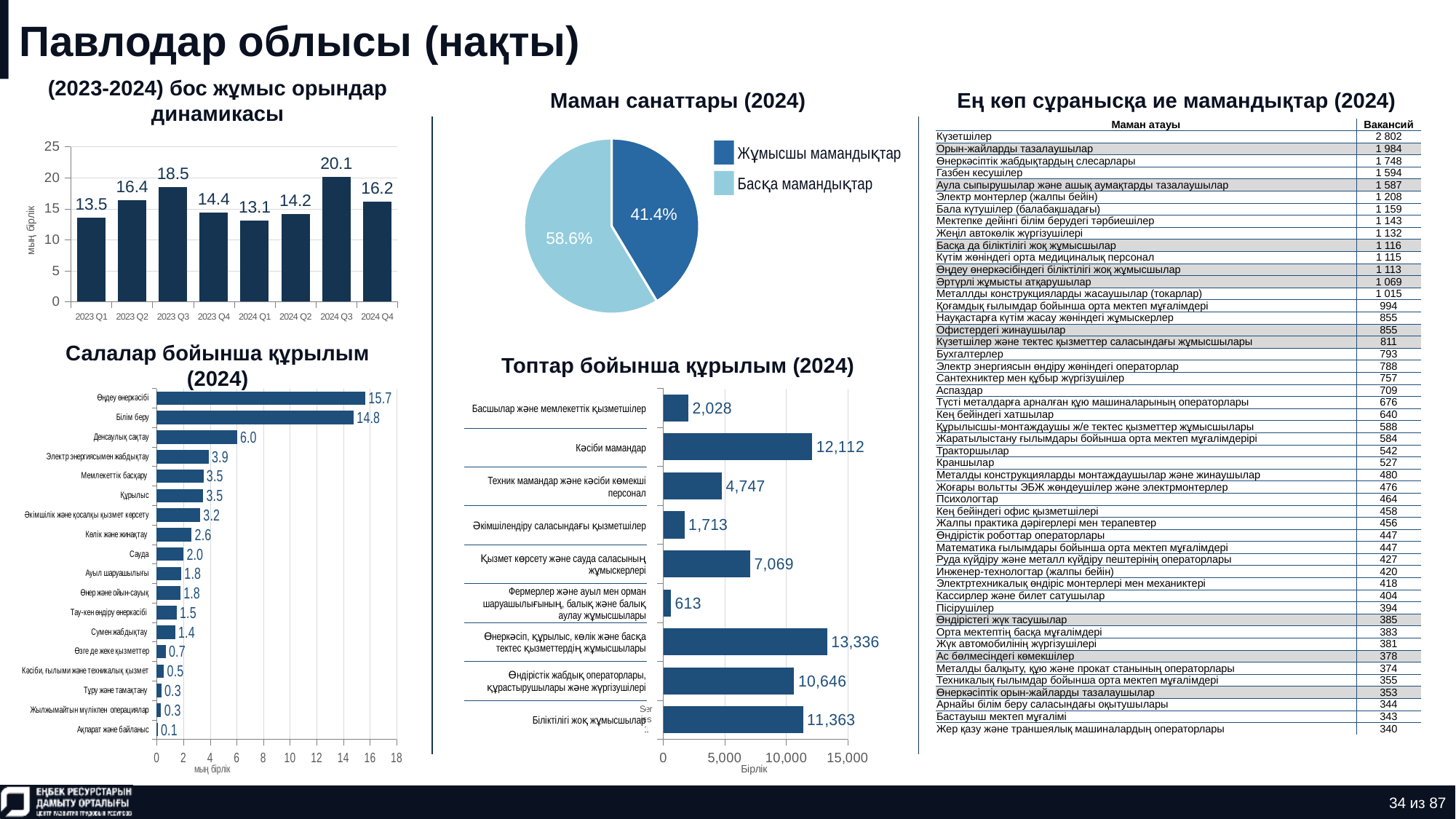
In the chart 'Топтар бойынша құрылым (2024)', what is the value for 'Кәсіби мамандар'? 12,112 In the chart '(2023-2024) бос жұмыс орындар динамикасы', what is the value for 2024 Q3? 20.1 In the chart '(2023-2024) бос жұмыс орындар динамикасы', what is the difference between 2024 Q3 and 2024 Q4? 3.9 In the chart 'Топтар бойынша құрылым (2024)', which is larger: 'Кәсіби мамандар' or 'Біліктілігі жоқ жұмысшылар'? Кәсіби мамандар In the pie chart 'Маман санаттары (2024)', what share is 'Жұмысшы мамандықтар'? 41.4% What kind of chart is 'Топтар бойынша құрылым (2024)'? bar chart In the chart '(2023-2024) бос жұмыс орындар динамикасы', which quarter has the lowest value? 2024 Q1 What kind of chart is 'Маман санаттары (2024)'? pie chart In the pie chart 'Маман санаттары (2024)', how many categories does the legend list? 2 In the chart '(2023-2024) бос жұмыс орындар динамикасы', how many quarters are plotted? 8 In the chart 'Салалар бойынша құрылым (2024)', what is the value for 'Білім беру'? 14.8 In the chart 'Салалар бойынша құрылым (2024)', which category has the highest value? Өңдеу өнеркәсібі